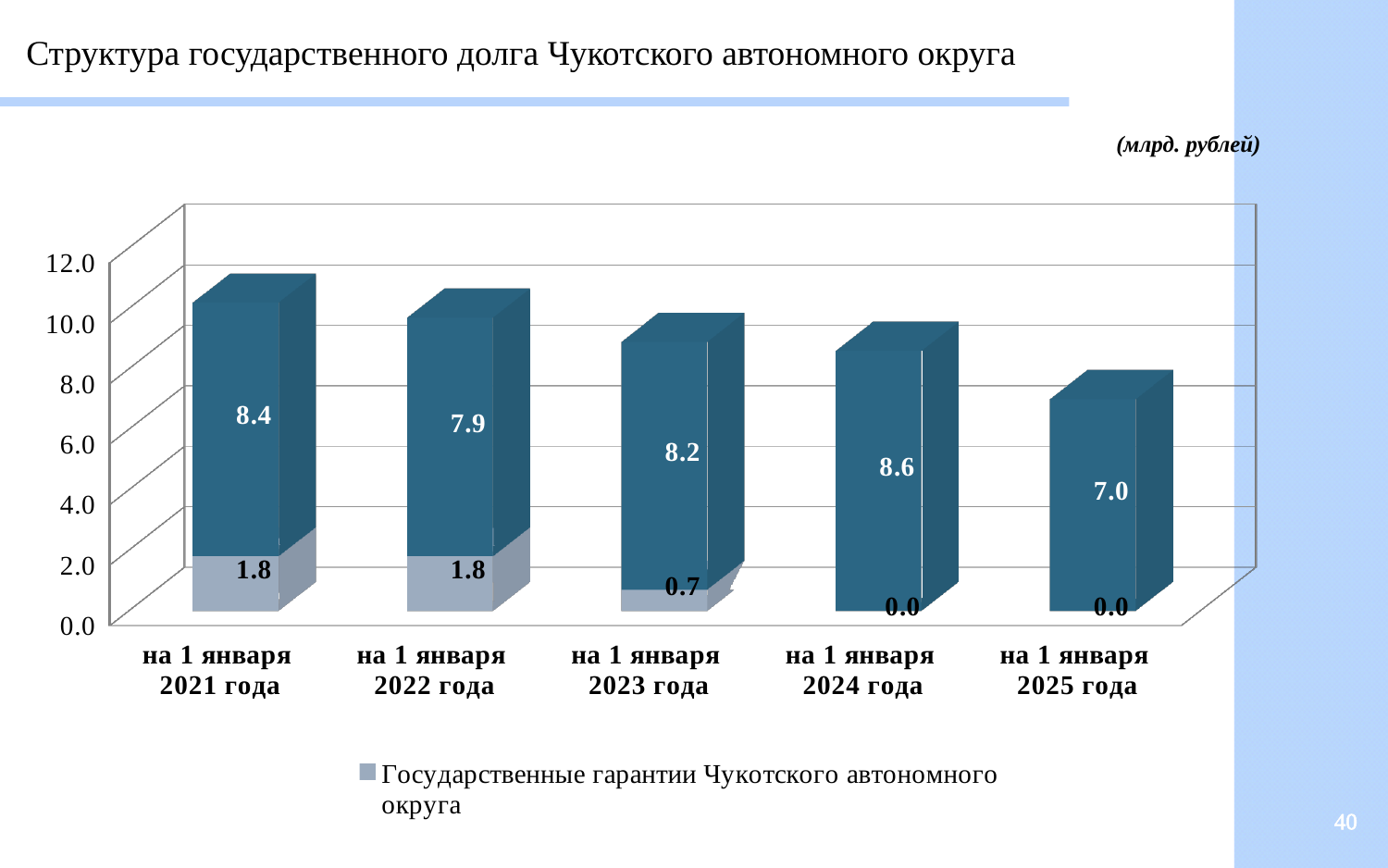
For which date is the dark blue (upper) segment the largest? на 1 января 2024 года What is the total of the stacked bar for на 1 января 2023 года? 8.9 How many dates (categories) are shown on the x axis? 5 What is the total of the stacked bar for на 1 января 2021 года? 10.2 What is the value of the dark blue (upper) segment for на 1 января 2022 года? 7.9 For which date is the dark blue (upper) segment the smallest? на 1 января 2025 года What type of chart is shown on the slide? bar chart What is the value of the Государственные гарантии Чукотского автономного округа segment for на 1 января 2024 года? 0.0 What is the value of the Государственные гарантии Чукотского автономного округа segment for на 1 января 2023 года? 0.7 What is the value of the Государственные гарантии Чукотского автономного округа segment for на 1 января 2021 года? 1.8 In what units are the values on the chart given? млрд. рублей What is the difference between the dark blue segment values for на 1 января 2024 года and на 1 января 2025 года? 1.6